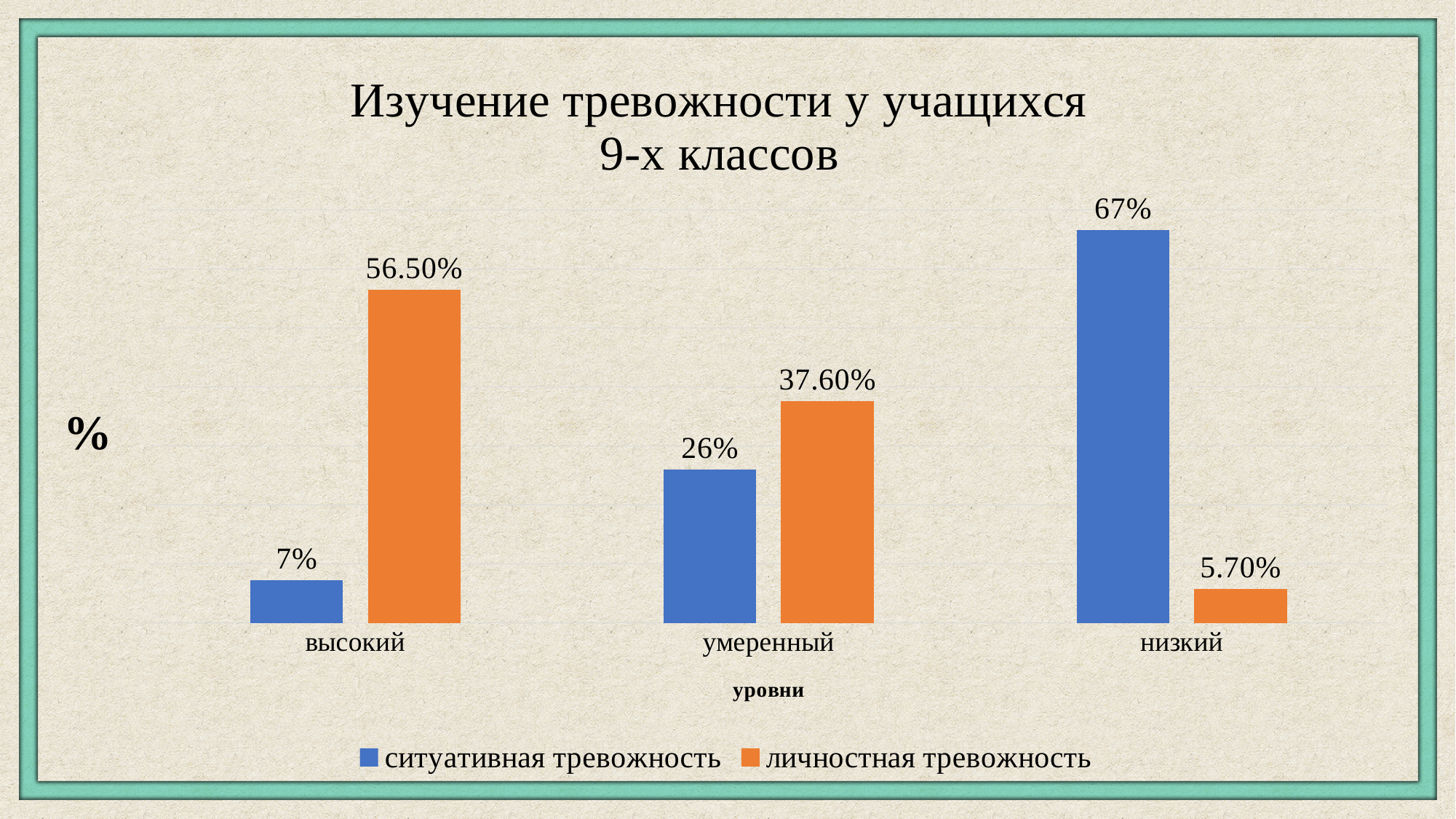
What is the value for ситуативная тревожность at the высокий level? 7% What is the value for личностная тревожность at the высокий level? 56.50% What is the value for ситуативная тревожность at the умеренный level? 26% What is the value for личностная тревожность at the низкий level? 5.70% At the низкий level, which series has the larger value: ситуативная тревожность or личностная тревожность? ситуативная тревожность How many series does the legend list? 2 What kind of chart is shown on the slide? bar chart Which level has the highest value for ситуативная тревожность? низкий What is the difference between личностная тревожность and ситуативная тревожность at the умеренный level? 11.60% What is the title of the chart? Изучение тревожности у учащихся 9-х классов How many levels are shown on the x axis? 3 Which level has the lowest value for личностная тревожность? низкий